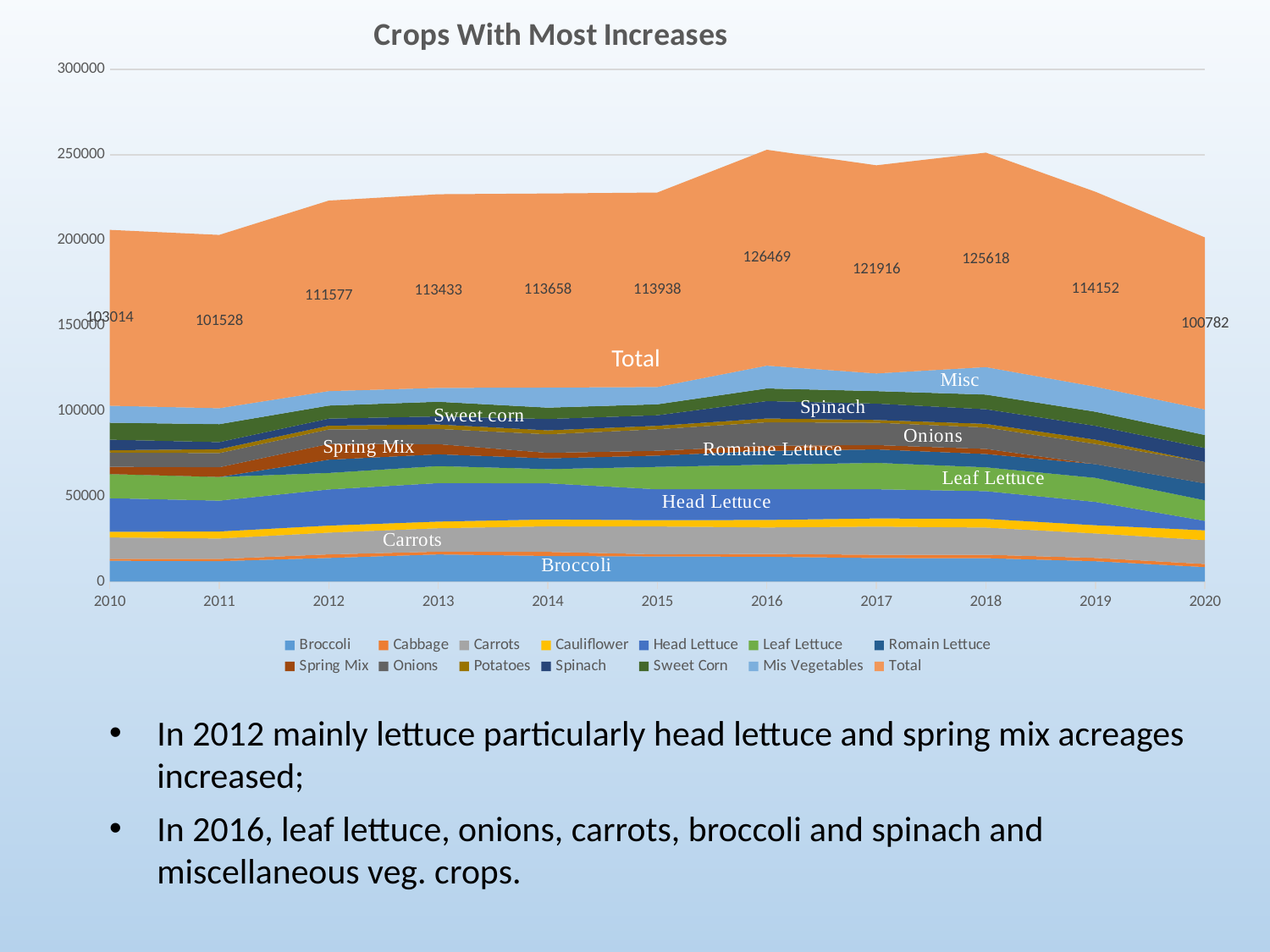
What kind of chart is shown on the slide? area chart What is the difference between the labelled Total values for 2016 and 2010? 23455 What is the labelled Total value for 2020? 100782 Do the labelled Total values rise or fall from 2018 to 2020? fall In which year is the labelled Total value lowest? 2020 How many series does the chart's legend list? 14 Which year has the larger labelled Total value, 2017 or 2018? 2018 In which year is the labelled Total value highest? 2016 What is the labelled Total value for 2012? 111577 What is the labelled Total value for 2016? 126469 What is the title of the chart? Crops With Most Increases How many years are shown along the x axis of the chart? 11